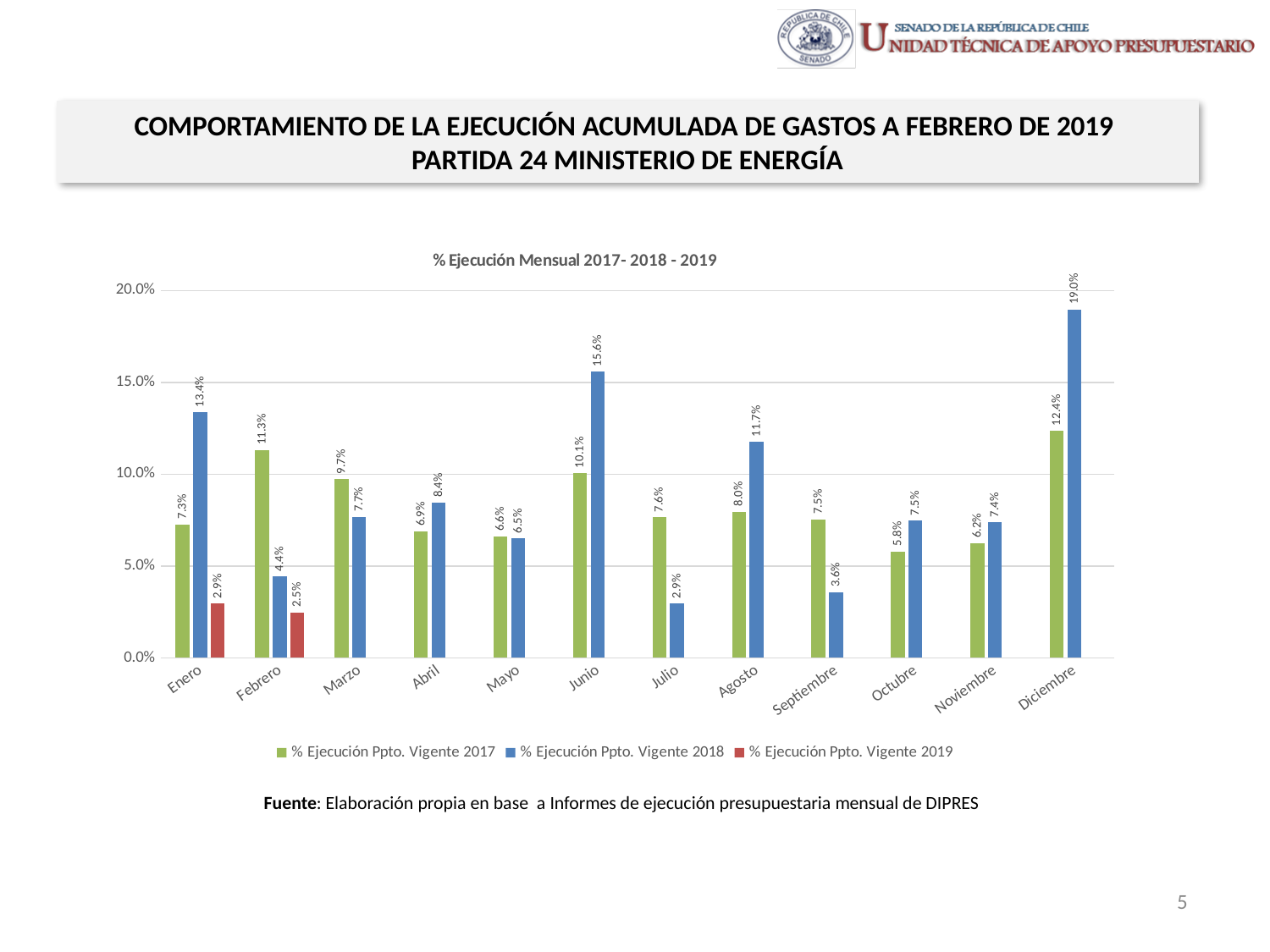
How many months are shown on the x axis? 12 What is the value for % Ejecución Ppto. Vigente 2018 in Junio? 15.6% Which is larger in Marzo: the 2017 value or the 2018 value? 2017 (9.7%) What kind of chart is shown? Bar chart Which month has the highest value for % Ejecución Ppto. Vigente 2018? Diciembre Which colour represents % Ejecución Ppto. Vigente 2019? Red What is the value for % Ejecución Ppto. Vigente 2017 in Diciembre? 12.4% What is the difference between the 2018 and 2017 values in Enero? 6.1% What is the title of the chart? % Ejecución Mensual 2017- 2018 - 2019 Which month has the lowest value for % Ejecución Ppto. Vigente 2017? Octubre How many series does the legend list? 3 What is the value for % Ejecución Ppto. Vigente 2019 in Febrero? 2.5%